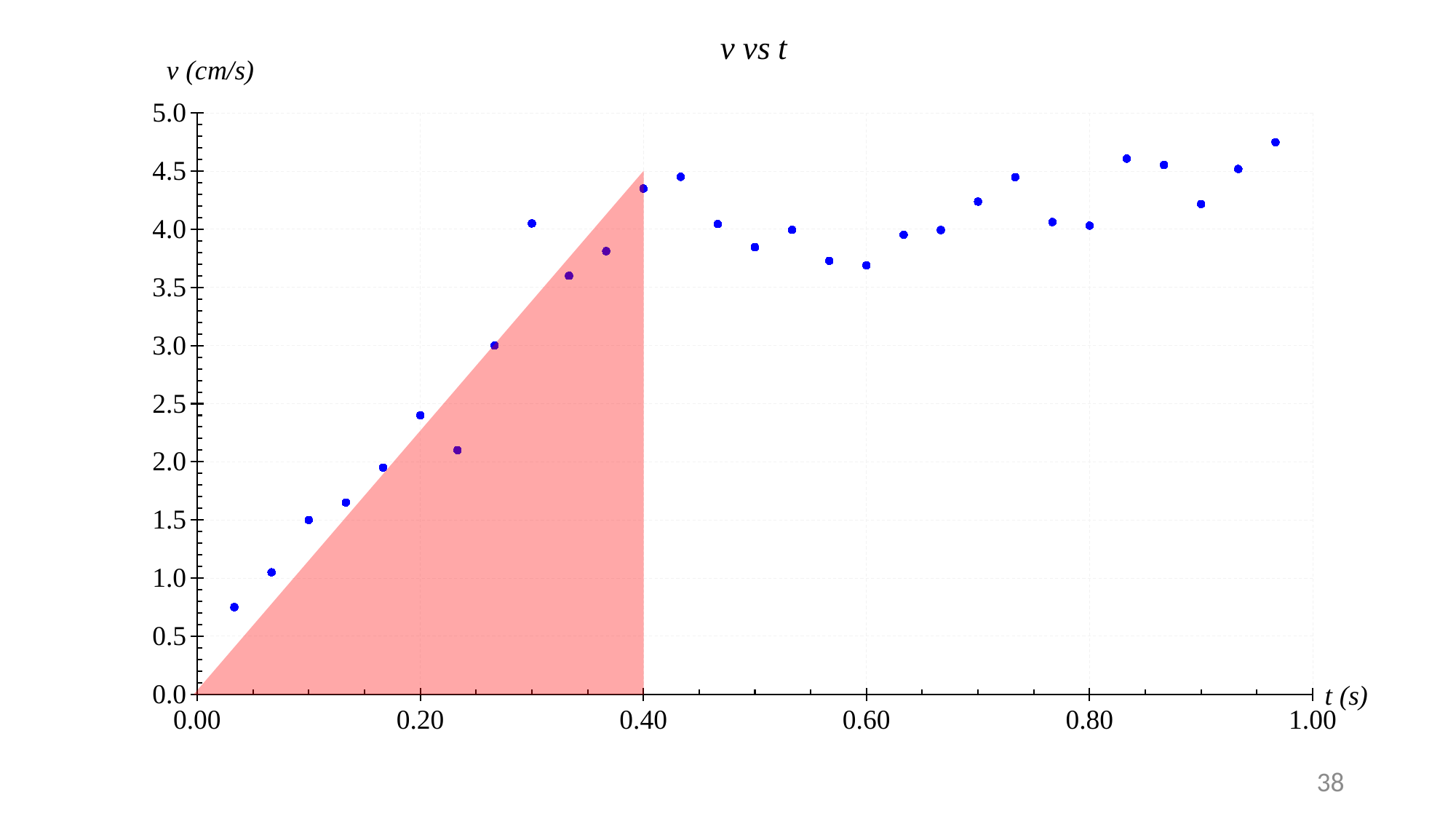
Is the value of v at t = 0.60 greater or less than 4.0? less Which point has the highest value of v? the last point, near t = 0.97 What is the label of the vertical axis? v (cm/s) Which point has the lowest value of v? the first point, near t = 0.03 Is the value of v for the first point (near t = 0.03) greater or less than 1.0? less Overall, do the plotted values of v rise or fall as t increases from 0.00 to 1.00? rise Is the value of v at t = 0.20 greater or less than 2.0? greater What is the title of the chart? v vs t Which has the larger value of v: the point at t = 0.20 or the point at t = 0.60? t = 0.60 What kind of chart is shown on the slide? scatter plot